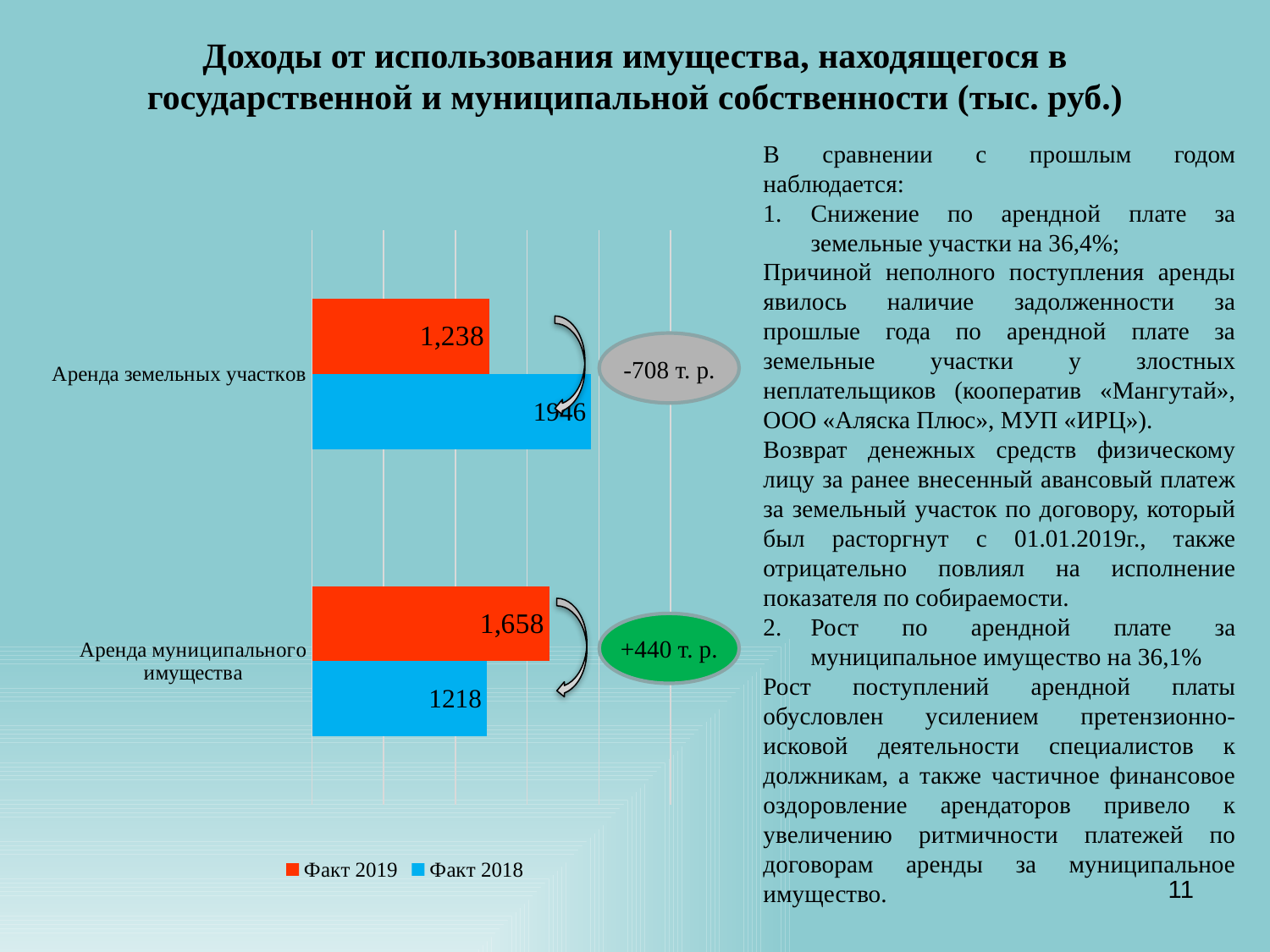
For Аренда земельных участков, which series has the larger value, Факт 2019 or Факт 2018? Факт 2018 What is the Факт 2018 value for Аренда муниципального имущества? 1218 Which category has the higher Факт 2019 value? Аренда муниципального имущества How many categories are shown on the chart? 2 For Аренда муниципального имущества, which series has the larger value, Факт 2019 or Факт 2018? Факт 2019 How many series does the chart legend list? 2 What colour represents the Факт 2018 series in the chart? blue What is the Факт 2019 value for Аренда земельных участков? 1,238 What is the Факт 2018 value for Аренда земельных участков? 1946 What is the Факт 2019 value for Аренда муниципального имущества? 1,658 What kind of chart is shown on the slide? bar chart What is the difference between the Факт 2019 and Факт 2018 values for Аренда муниципального имущества? 440